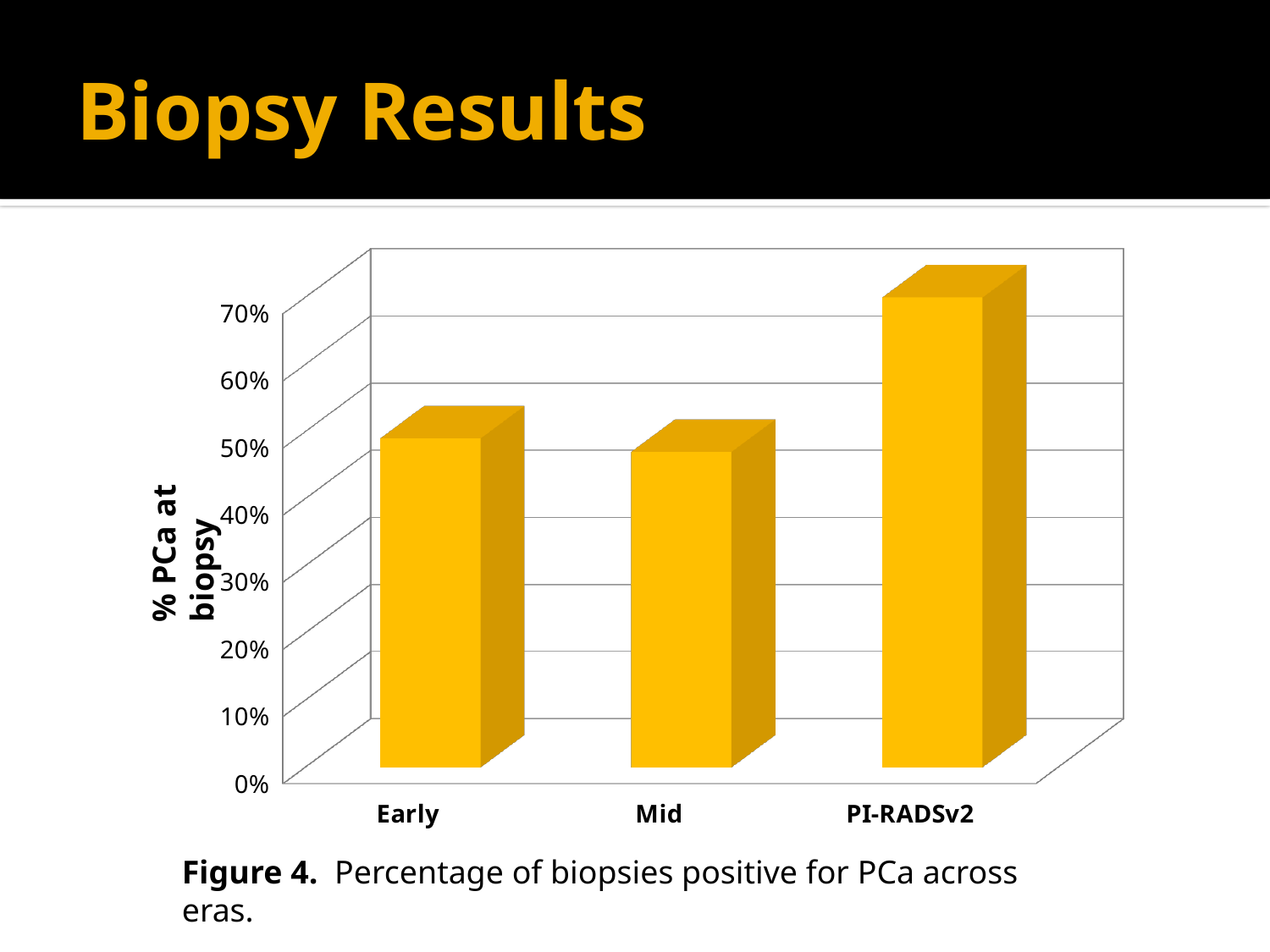
Which is larger, the value for Early or the value for PI-RADSv2? PI-RADSv2 Is the value for Early greater or less than 40%? greater Which is larger, the value for Mid or the value for PI-RADSv2? PI-RADSv2 Is the value for Mid greater or less than 60%? less What is the label of the third category on the x axis? PI-RADSv2 How many categories are shown on the x axis of the chart? 3 Is the value for Early greater or less than 60%? less What kind of chart is shown on the slide? bar chart What is the label on the vertical axis of the chart? % PCa at biopsy Which category has the highest value in the chart? PI-RADSv2